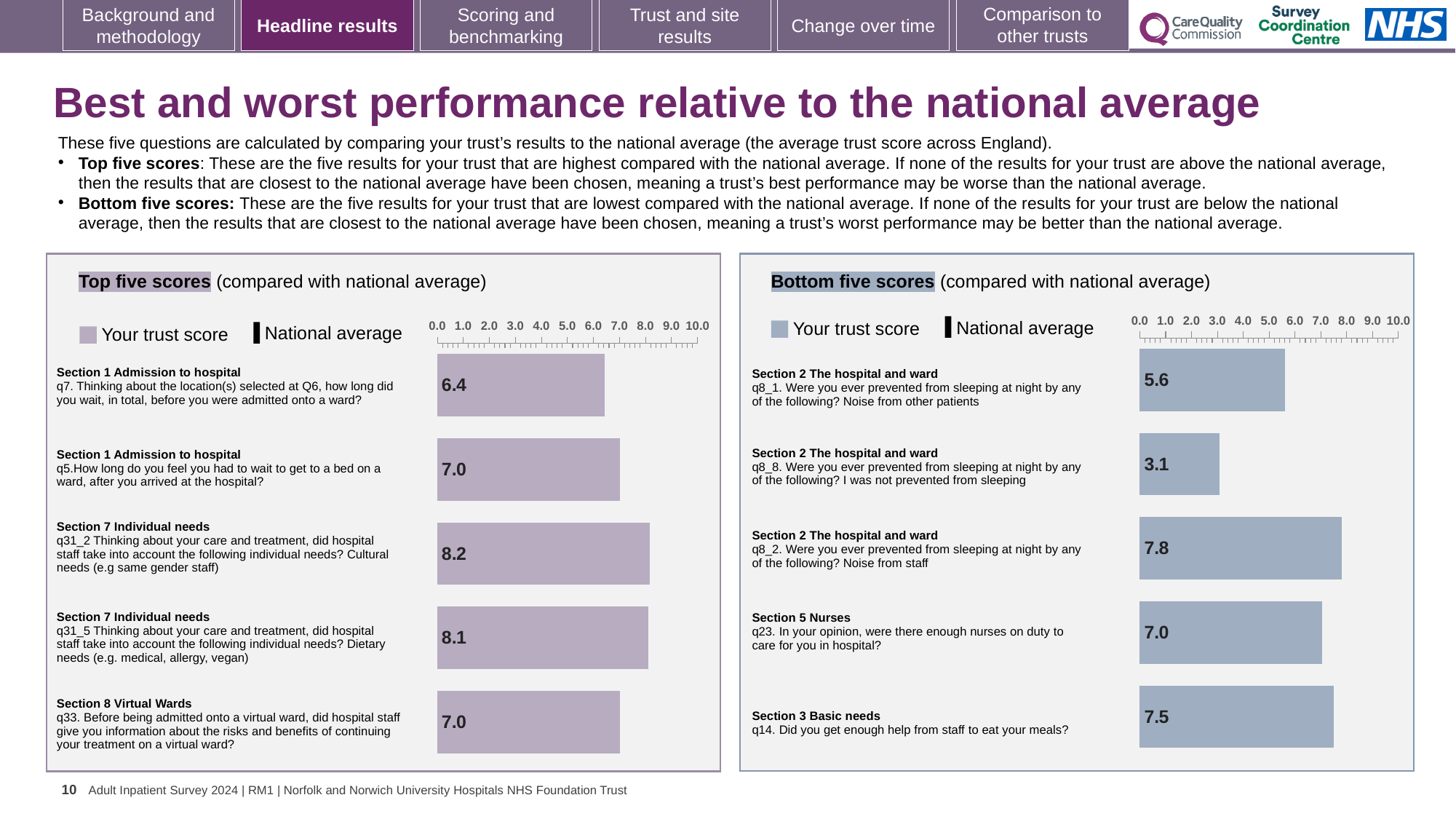
In the Top five scores chart, what is the trust score for q31_2 (cultural needs)? 8.2 How many series does the legend of the Top five scores chart list? 2 In the Bottom five scores chart, what is the difference between the score for q8_2 and the score for q8_8? 4.7 In the Top five scores chart, what is the difference between the highest score (q31_2) and the lowest score (q7)? 1.8 In the Bottom five scores chart, which question has the lowest trust score? q8_8 (I was not prevented from sleeping) In the Bottom five scores chart, what is the trust score for q23 (enough nurses on duty)? 7.0 In the Bottom five scores chart, which is larger: the score for q14 or the score for q8_1? q14 How many questions are shown in the Bottom five scores chart? 5 In the Top five scores chart, which question has the highest trust score? q31_2 (cultural needs) In the Bottom five scores chart, what is the trust score for q8_8 (I was not prevented from sleeping)? 3.1 In the Top five scores chart, what is the trust score for q7 (how long did you wait before being admitted onto a ward)? 6.4 In the Bottom five scores chart, which question has the highest trust score? q8_2 (noise from staff)